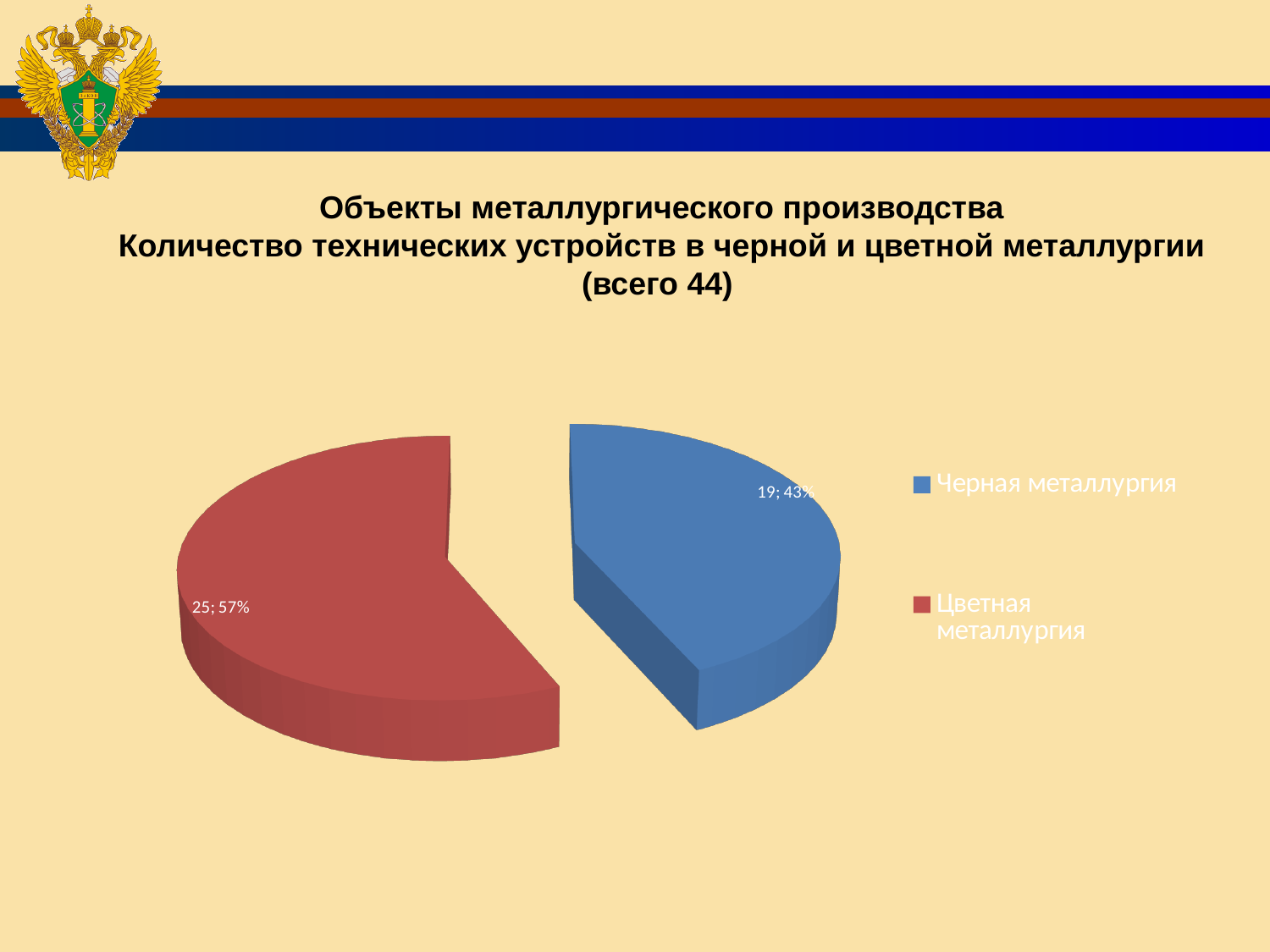
What is the difference between the values for Цветная металлургия and Черная металлургия? 6 What share of the pie does Цветная металлургия represent? 57% What colour is the slice for Черная металлургия? blue Which category has the largest slice? Цветная металлургия What kind of chart is shown on the slide? pie chart How many entries does the legend list? 2 How many slices does the pie chart have? 2 Which category has the smallest slice? Черная металлургия What share of the pie does Черная металлургия represent? 43% What is the value for Цветная металлургия? 25 Which is larger, the value for Черная металлургия or Цветная металлургия? Цветная металлургия What is the value for Черная металлургия? 19